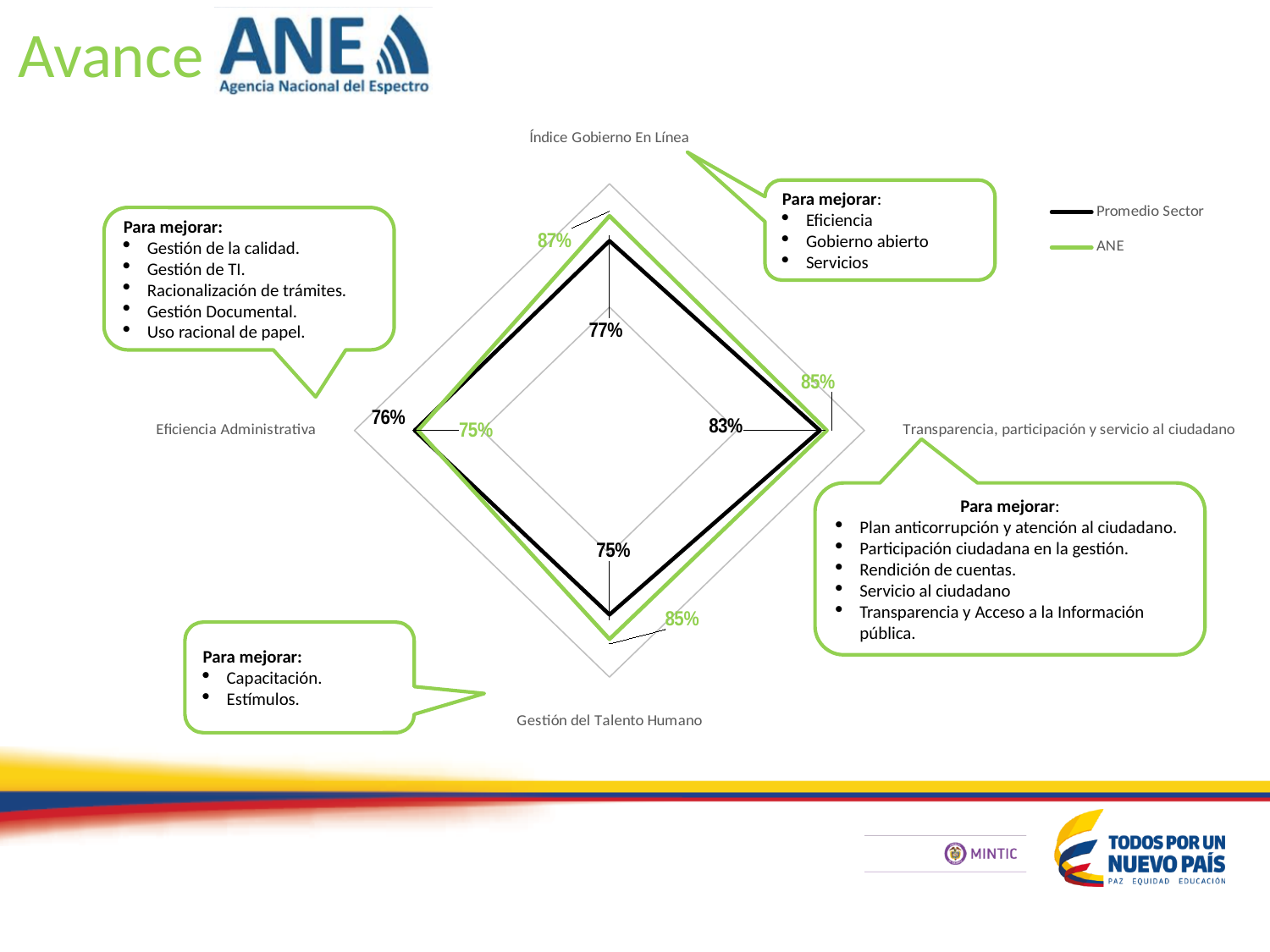
How many series does the chart legend list? 2 What is the Promedio Sector value for Eficiencia Administrativa? 76% What is the difference between the ANE and Promedio Sector values for Gestión del Talento Humano? 10% In which category does ANE have its highest value? Índice Gobierno En Línea Which series is drawn in green on the chart? ANE What is the ANE value for Gestión del Talento Humano? 85% In which category does Promedio Sector have its lowest value? Gestión del Talento Humano What kind of chart is shown on the slide? Radar chart What is the Promedio Sector value for Índice Gobierno En Línea? 77% How many categories (axes) does the radar chart have? 4 What is the ANE value for Índice Gobierno En Línea? 87% What is the Promedio Sector value for Transparencia, participación y servicio al ciudadano? 83%